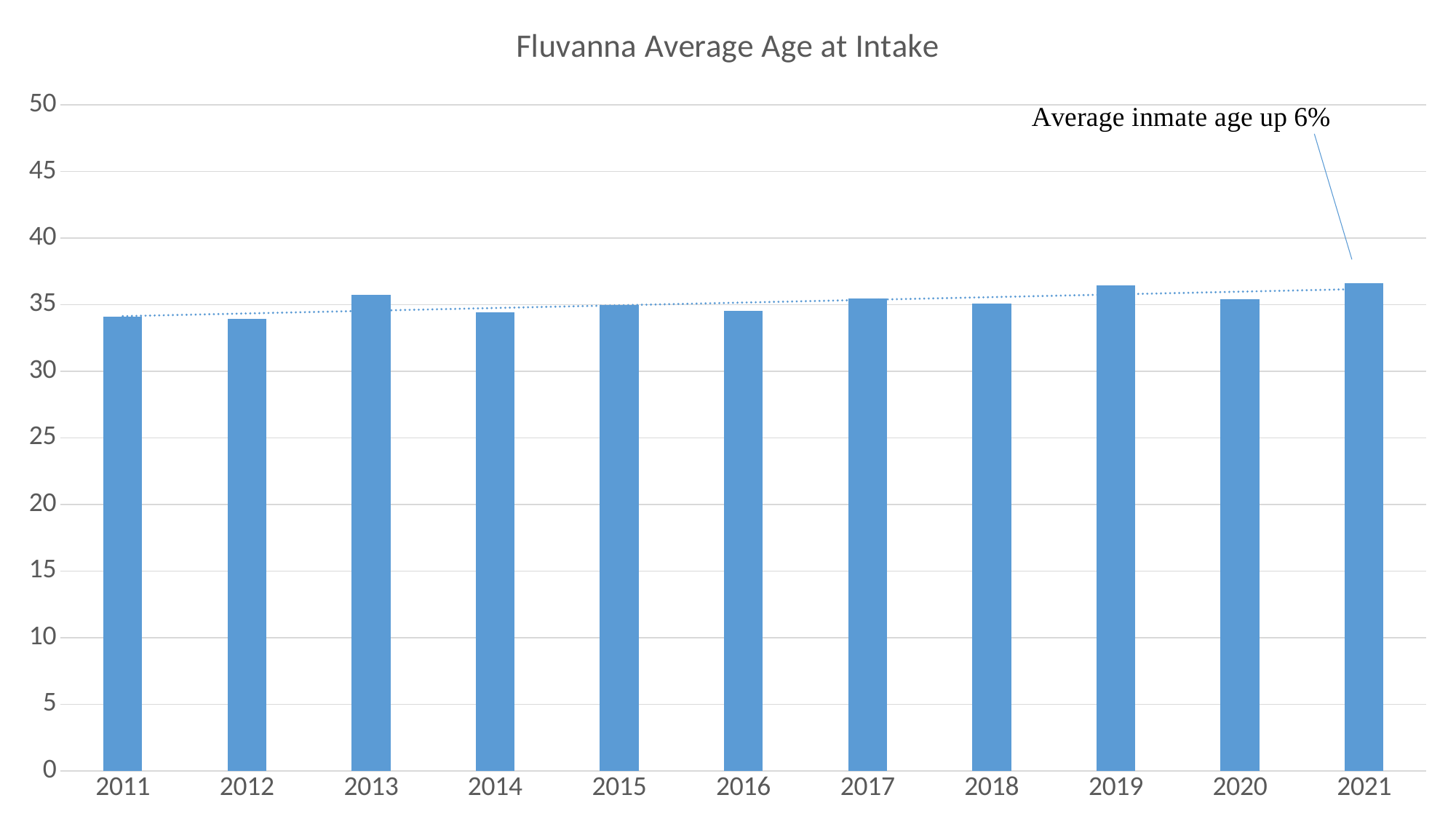
Is the value for 2021 greater or less than 35? greater Which year has the larger value, 2011 or 2021? 2021 Do the values generally rise or fall from 2011 to 2021? rise Is the value for 2019 greater or less than 40? less Is the value for 2016 greater or less than 35? less What is the title of the chart? Fluvanna Average Age at Intake What kind of chart is shown on the slide? bar chart What does the annotation text on the chart say? Average inmate age up 6% Which year has the larger value, 2012 or 2013? 2013 How many years are shown on the x axis of the chart? 11